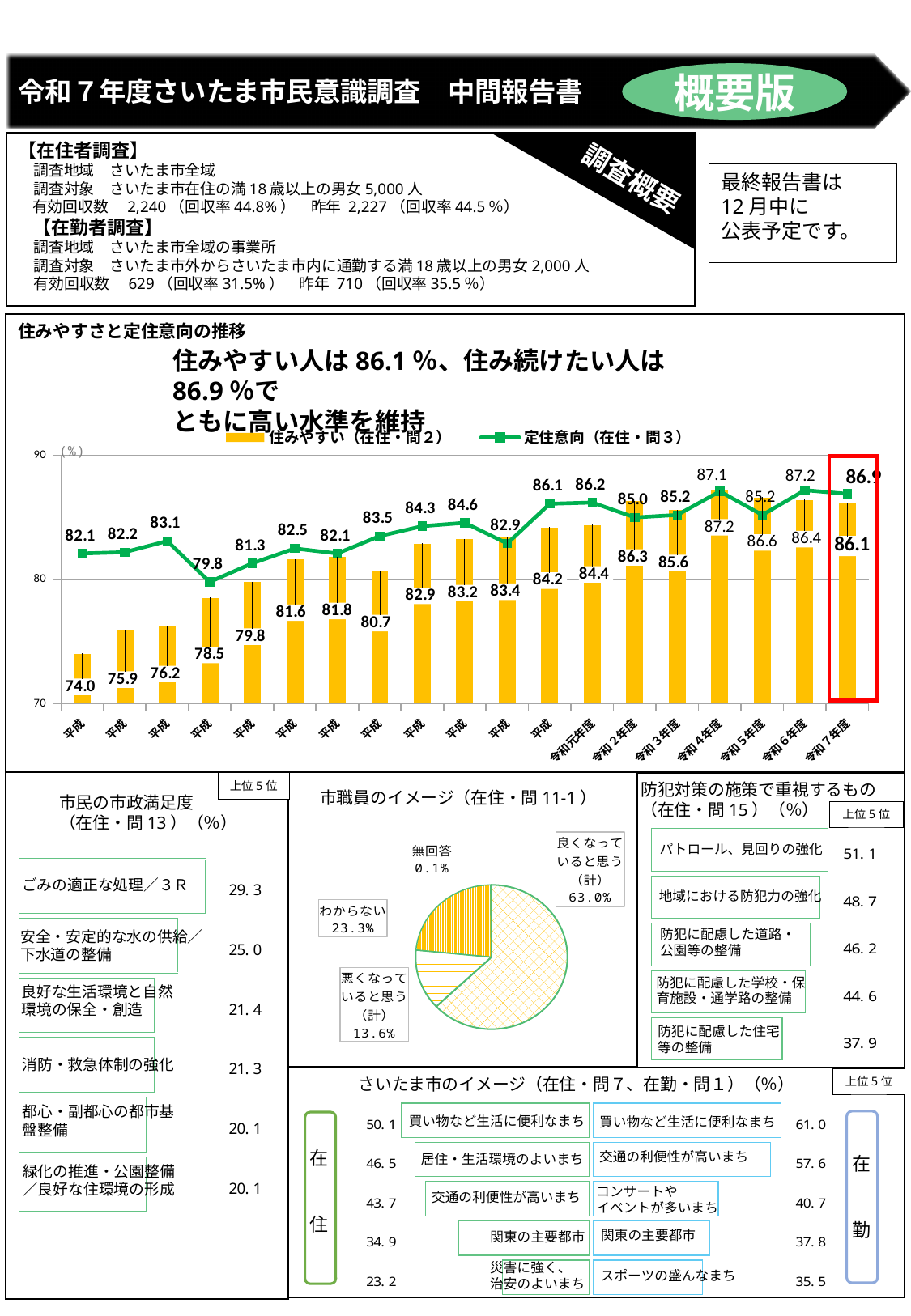
In the chart 住みやすさと定住意向の推移, what is the difference between the 住みやすい values for 令和4年度 and 令和7年度? 1.1 What kind of chart is 住みやすさと定住意向の推移? Combined bar and line chart In the pie chart 市職員のイメージ, what share is 良くなっていると思う（計）? 63.0% In the chart 住みやすさと定住意向の推移, what is the 定住意向 value for 令和5年度? 85.2 In the pie chart 市職員のイメージ, which slice is the smallest? 無回答 How many series does the legend of the chart 住みやすさと定住意向の推移 list? 2 How many years (categories) are plotted in the chart 住みやすさと定住意向の推移? 19 In the chart 住みやすさと定住意向の推移, for 令和6年度, which is larger: 住みやすい or 定住意向? 定住意向 In the chart 住みやすさと定住意向の推移, which year has the highest 住みやすい value? 令和4年度 In the chart 住みやすさと定住意向の推移, what is the 定住意向 value for 令和7年度? 86.9 In the chart 住みやすさと定住意向の推移, what is the 住みやすい value for 令和7年度? 86.1 In the chart 住みやすさと定住意向の推移, do the 住みやすい values generally rise or fall from the first year to the last? Rise